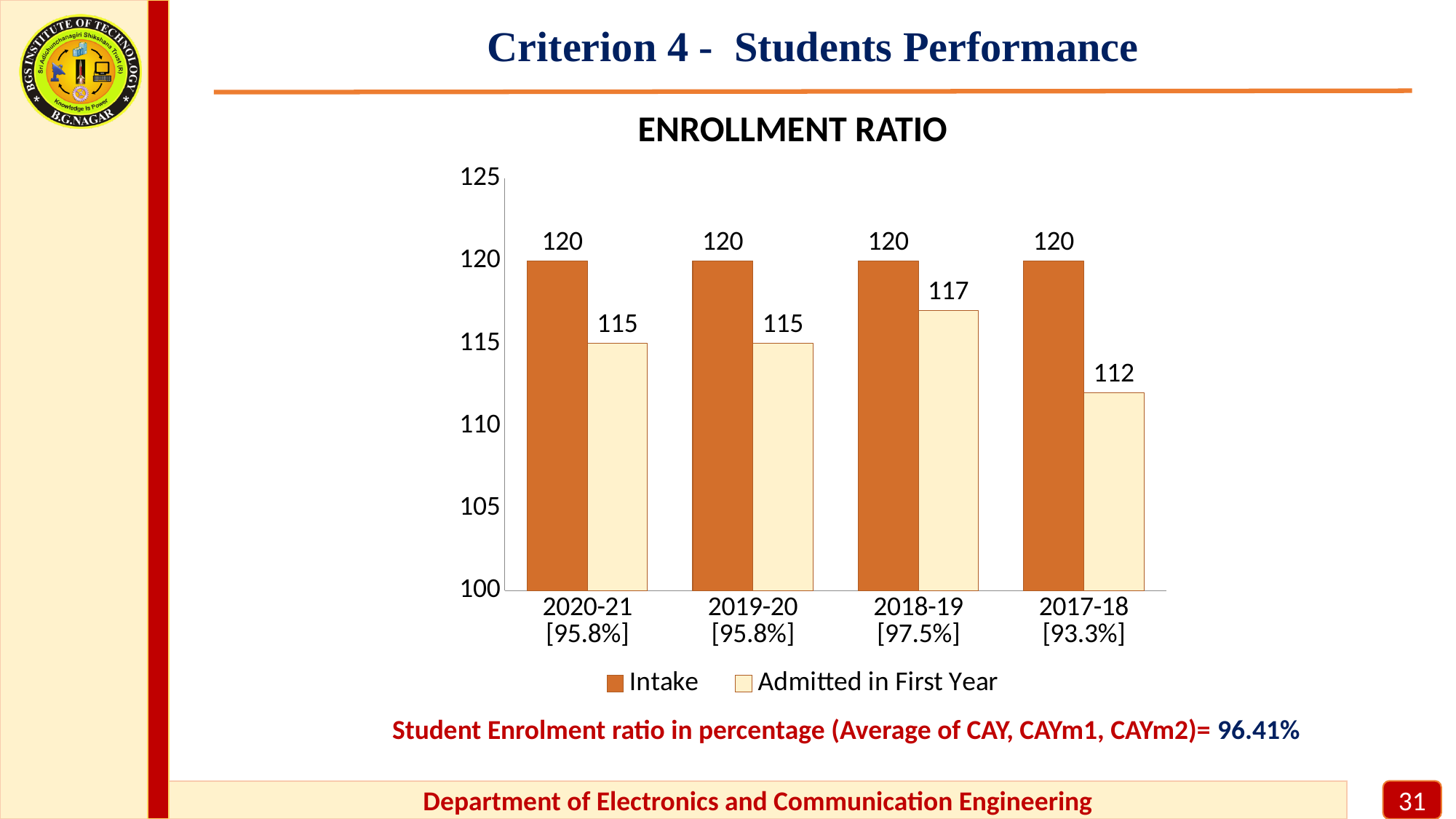
Which year has the highest Admitted in First Year value? 2018-19 [97.5%] What is the Admitted in First Year value for 2018-19 [97.5%]? 117 Which year has the lowest Admitted in First Year value? 2017-18 [93.3%] Which is larger, the Admitted in First Year value for 2019-20 [95.8%] or for 2017-18 [93.3%]? 2019-20 [95.8%] What is the Intake value for 2020-21 [95.8%]? 120 What is the difference between the Admitted in First Year values for 2018-19 [97.5%] and 2019-20 [95.8%]? 2 What is the title of the chart? ENROLLMENT RATIO How many years are shown on the x axis? 4 What kind of chart is shown? bar chart What is the difference between Intake and Admitted in First Year for 2017-18 [93.3%]? 8 How many series does the legend list? 2 What is the Admitted in First Year value for 2017-18 [93.3%]? 112